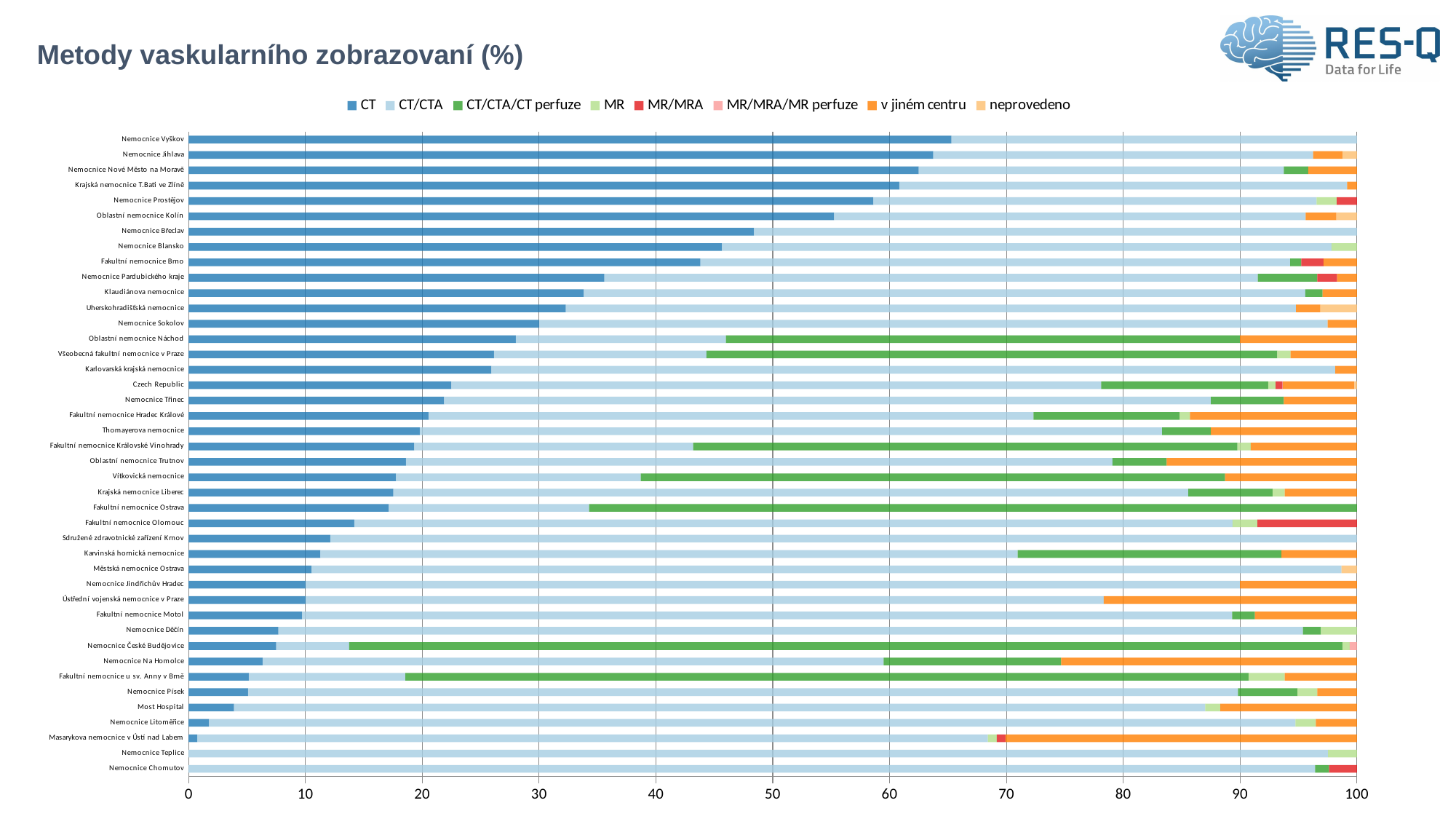
Which series is listed first in the legend? CT Is the CT value for Nemocnice Vyškov greater or less than 60? greater Do the CT values rise or fall going from the top category to the bottom category? fall How many hospitals/categories are plotted on the chart? 42 Is the CT value for Nemocnice Litoměřice greater or less than 10? less Which category has the highest CT value? Nemocnice Vyškov Is the CT value for Oblastní nemocnice Kolín greater or less than 50? greater How many series does the legend list? 8 What kind of chart is shown on the slide? stacked bar chart Which has a larger CT value, Nemocnice Vyškov or Nemocnice Na Homolce? Nemocnice Vyškov What is the title of the chart? Metody vaskularního zobrazovaní (%)